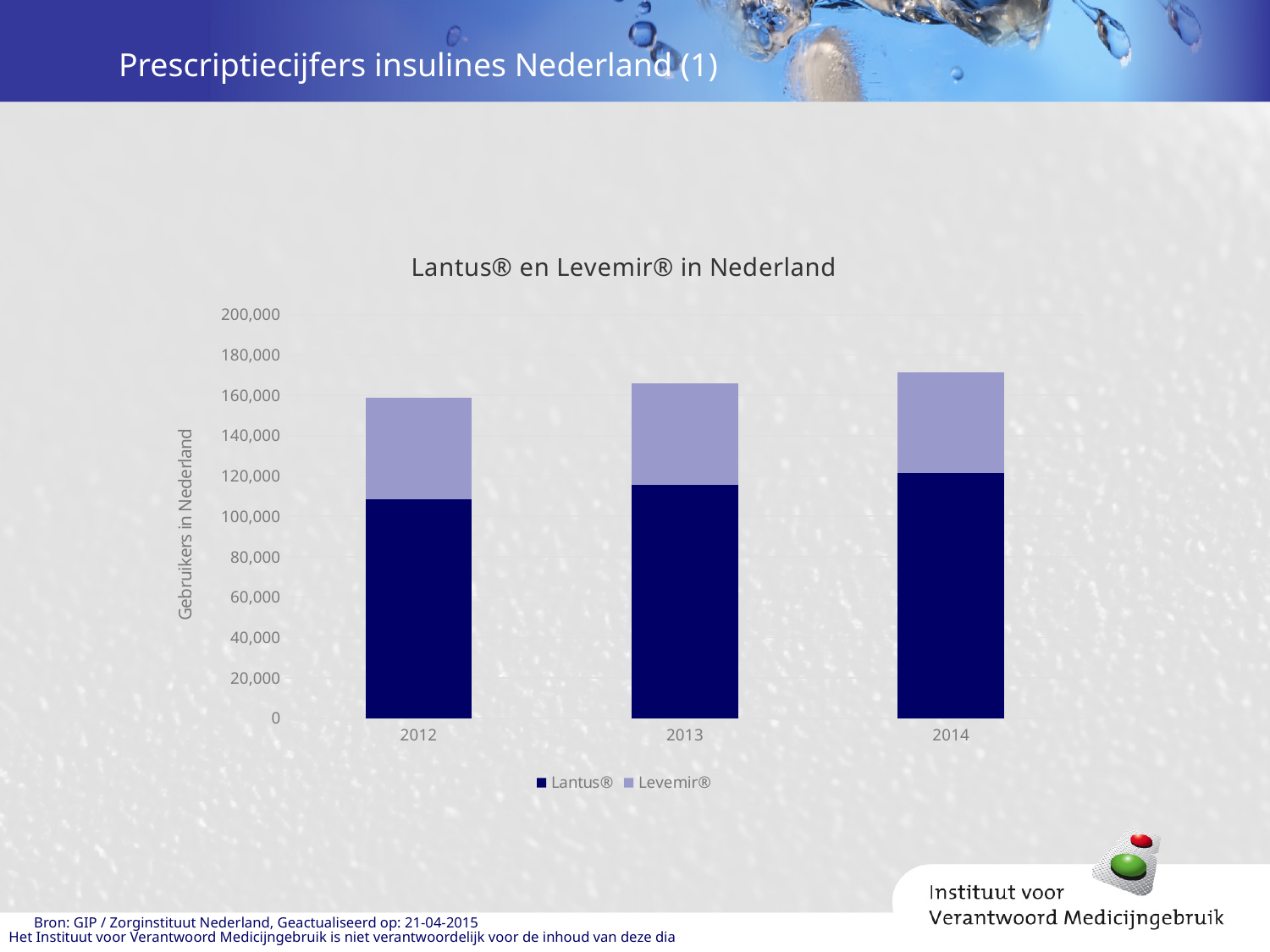
In which year is the total stacked bar the tallest? 2014 What kind of chart is shown on the slide? Stacked bar chart What is the label of the vertical axis? Gebruikers in Nederland Is the Lantus® value for 2012 greater or less than 100,000? greater Is the Lantus® value for 2013 greater or less than 120,000? less In which year is the Lantus® value lowest? 2012 How many years are shown on the x axis? 3 Do the Lantus® values rise or fall from 2012 to 2014? rise Is the total of the stacked bar for 2014 greater or less than 160,000? greater In which year is the Lantus® value highest? 2014 How many series does the legend list? 2 What is the title of the chart? Lantus® en Levemir® in Nederland